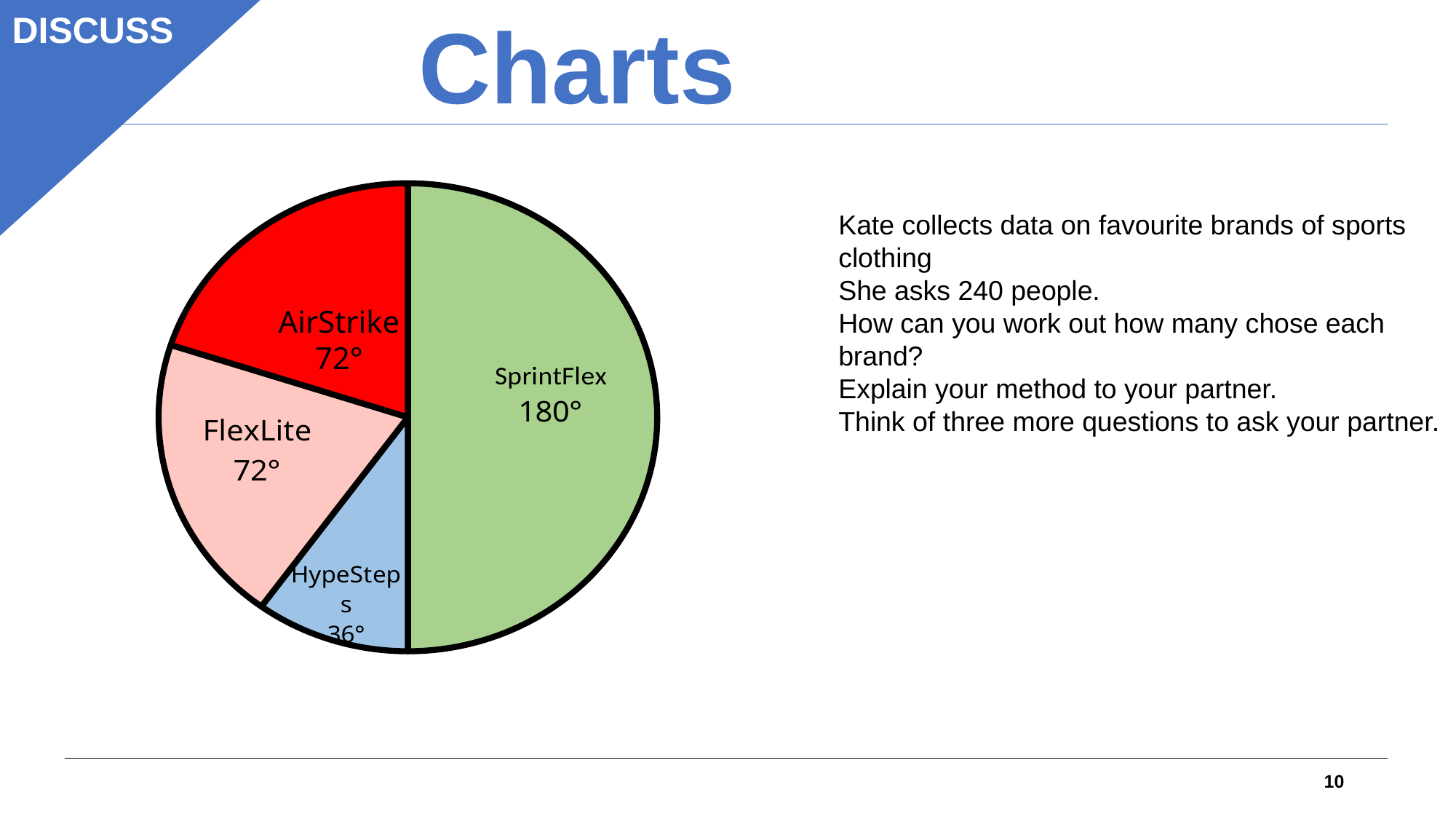
What angle is shown for the SprintFlex slice? 180° What colour is the SprintFlex slice? green Which brand has the largest slice of the pie chart? SprintFlex How many slices does the pie chart have? 4 What kind of chart is shown on the slide? pie chart What angle is shown for the HypeSteps slice? 36° Which brand has the smallest slice of the pie chart? HypeSteps What angle is shown for the AirStrike slice? 72° What share of the whole pie does the SprintFlex slice represent? 50% Which slice is larger, FlexLite or HypeSteps? FlexLite What angle is shown for the FlexLite slice? 72° What is the difference in degrees between the SprintFlex slice and the AirStrike slice? 108°